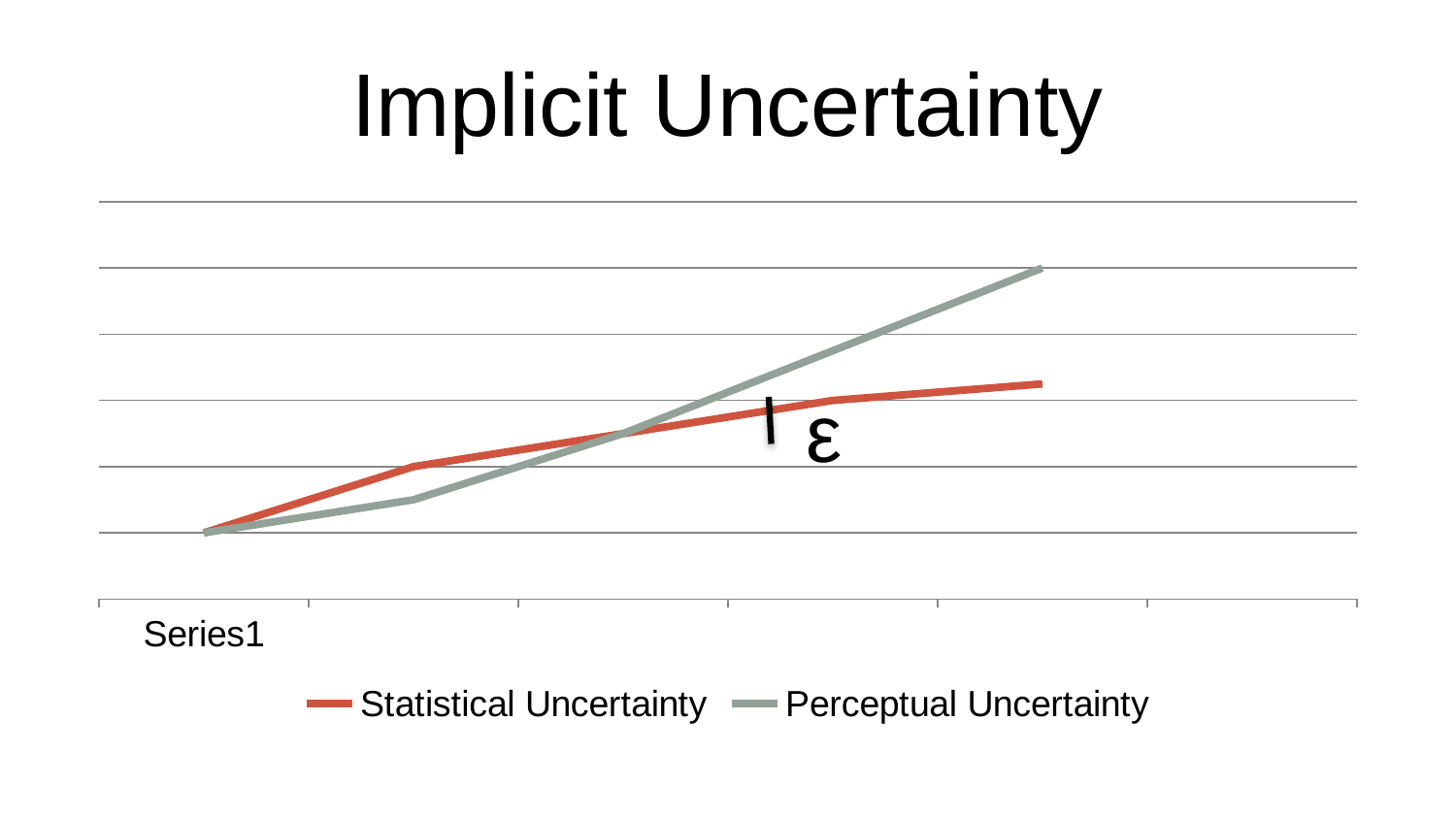
At the second point from the left, which series has the higher value, Statistical Uncertainty or Perceptual Uncertainty? Statistical Uncertainty Does the Statistical Uncertainty line rise or fall from left to right? rise What is the title of the chart? Implicit Uncertainty What kind of chart is shown on the slide? line chart Which series is drawn in red? Statistical Uncertainty At the right-hand end of the chart, which series has the higher value, Statistical Uncertainty or Perceptual Uncertainty? Perceptual Uncertainty What is the only category label shown on the x axis? Series1 How many data points does each line have? 5 How many series does the legend list? 2 Does the Perceptual Uncertainty line rise or fall from left to right? rise Which series reaches the highest value on the chart? Perceptual Uncertainty